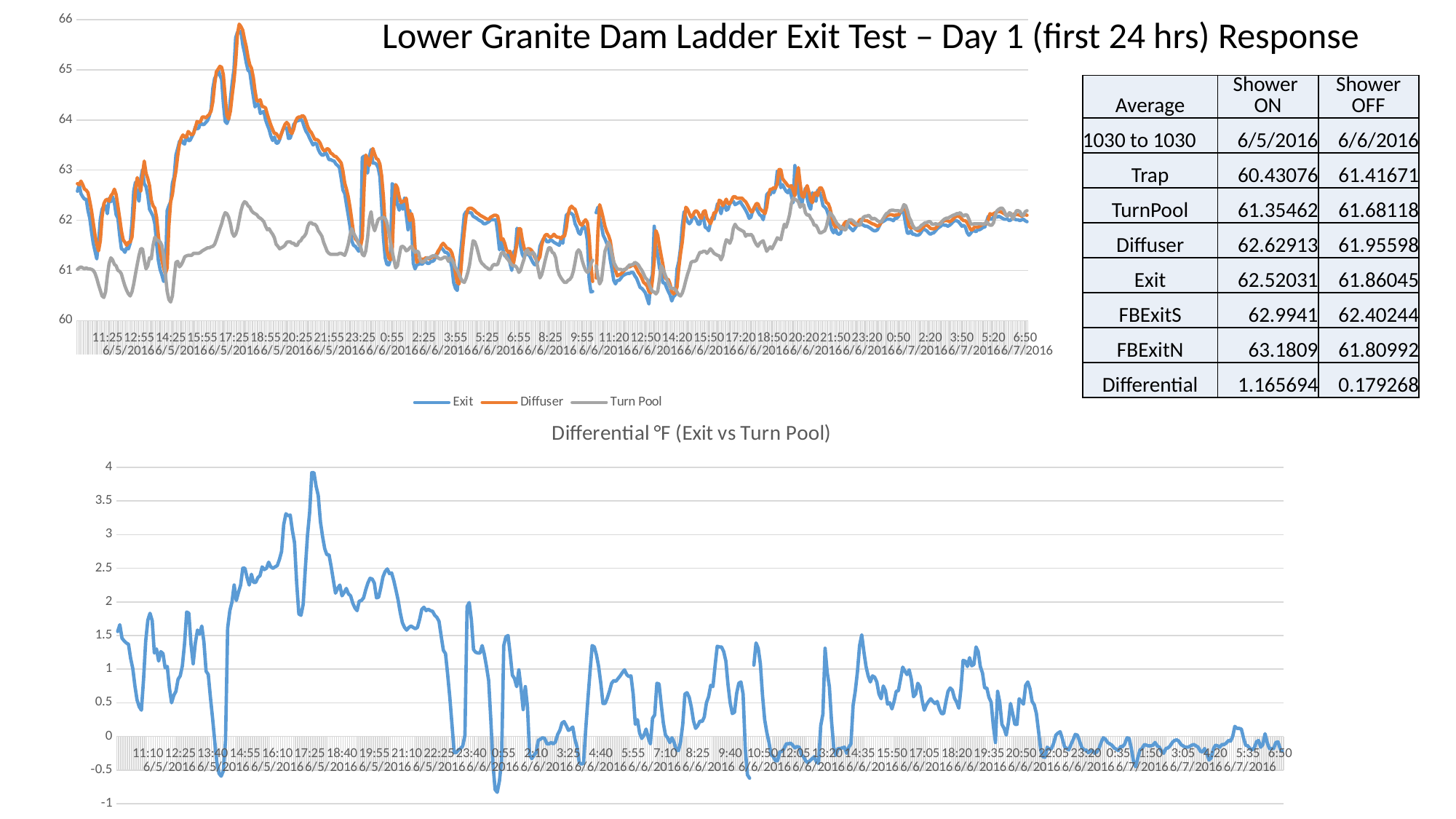
What kind of chart is the top chart on the slide? line chart In the top chart, is the peak value of the Diffuser series greater or less than 65? greater How many series does the legend of the top chart list? 3 In the top chart, which series is the lowest for most of the time period shown? Turn Pool In the bottom chart, do the differential values generally rise or fall from the peak at 17:25 on 6/5/2016 to the end of the series on 6/7/2016? fall What are the three series named in the legend of the top chart? Exit, Diffuser, Turn Pool In the bottom chart, is the lowest value (near 0:55 on 6/6/2016) greater or less than -0.5? less In the top chart, around 17:25 on 6/5/2016, which is larger: the Exit value or the Turn Pool value? Exit What is the title of the bottom chart? Differential °F (Exit vs Turn Pool) In the top chart, is the highest value of the Turn Pool series greater or less than 63? less What kind of chart is the bottom chart on the slide? line chart